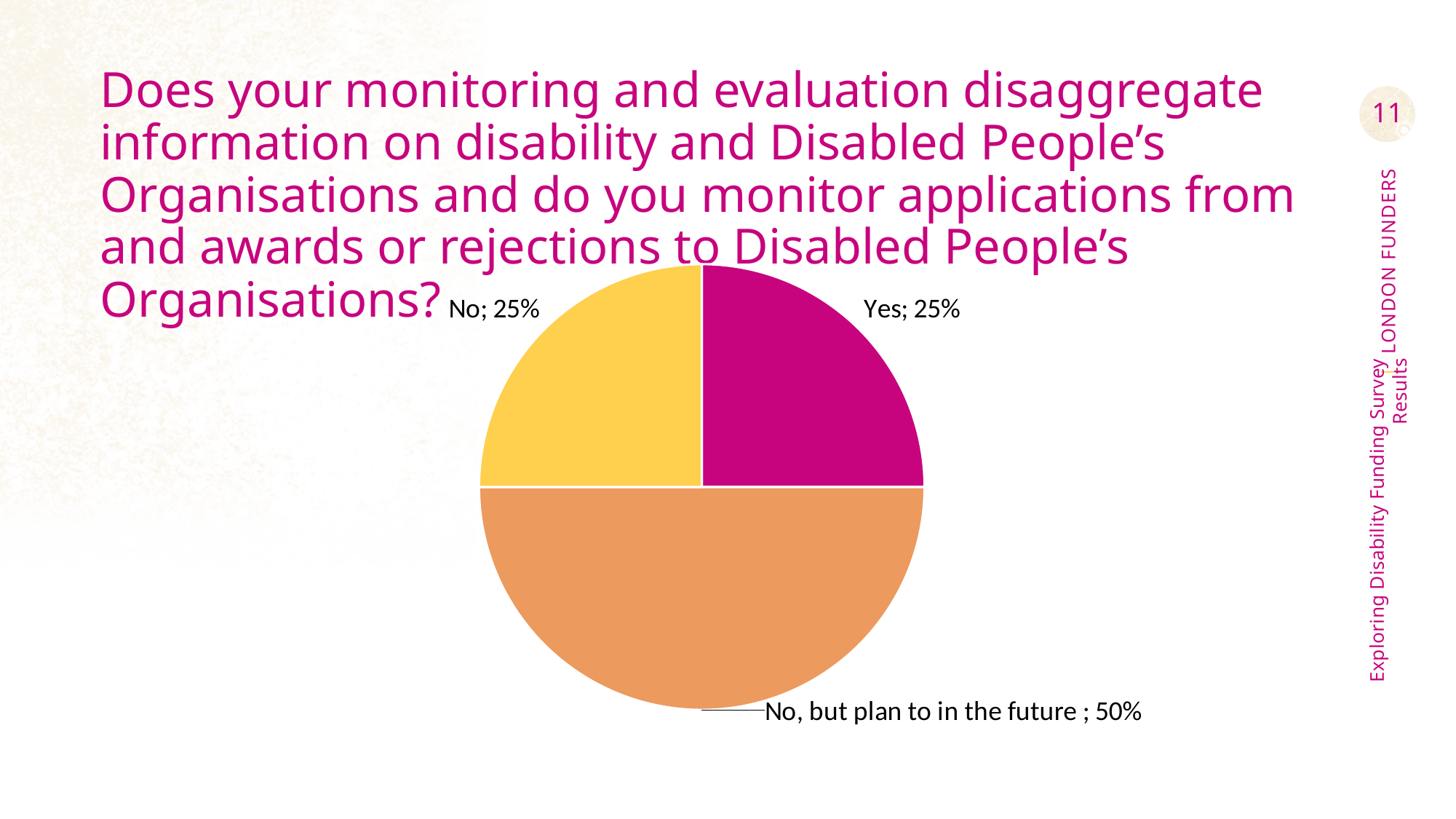
What share of the pie is labelled "No, but plan to in the future"? 50% What colour is the "No, but plan to in the future" slice of the pie? Orange How many slices does the pie chart have? 3 What is the combined share of the "Yes" and "No" slices? 50% Which slice of the pie is the largest? No, but plan to in the future What colour is the "Yes" slice of the pie? Magenta Which is larger, the "No, but plan to in the future" slice or the "No" slice? No, but plan to in the future What kind of chart is shown on the slide? Pie chart What is the difference between the "No, but plan to in the future" share and the "Yes" share? 25% What share of the pie is labelled "No"? 25% What share of the pie is labelled "Yes"? 25%